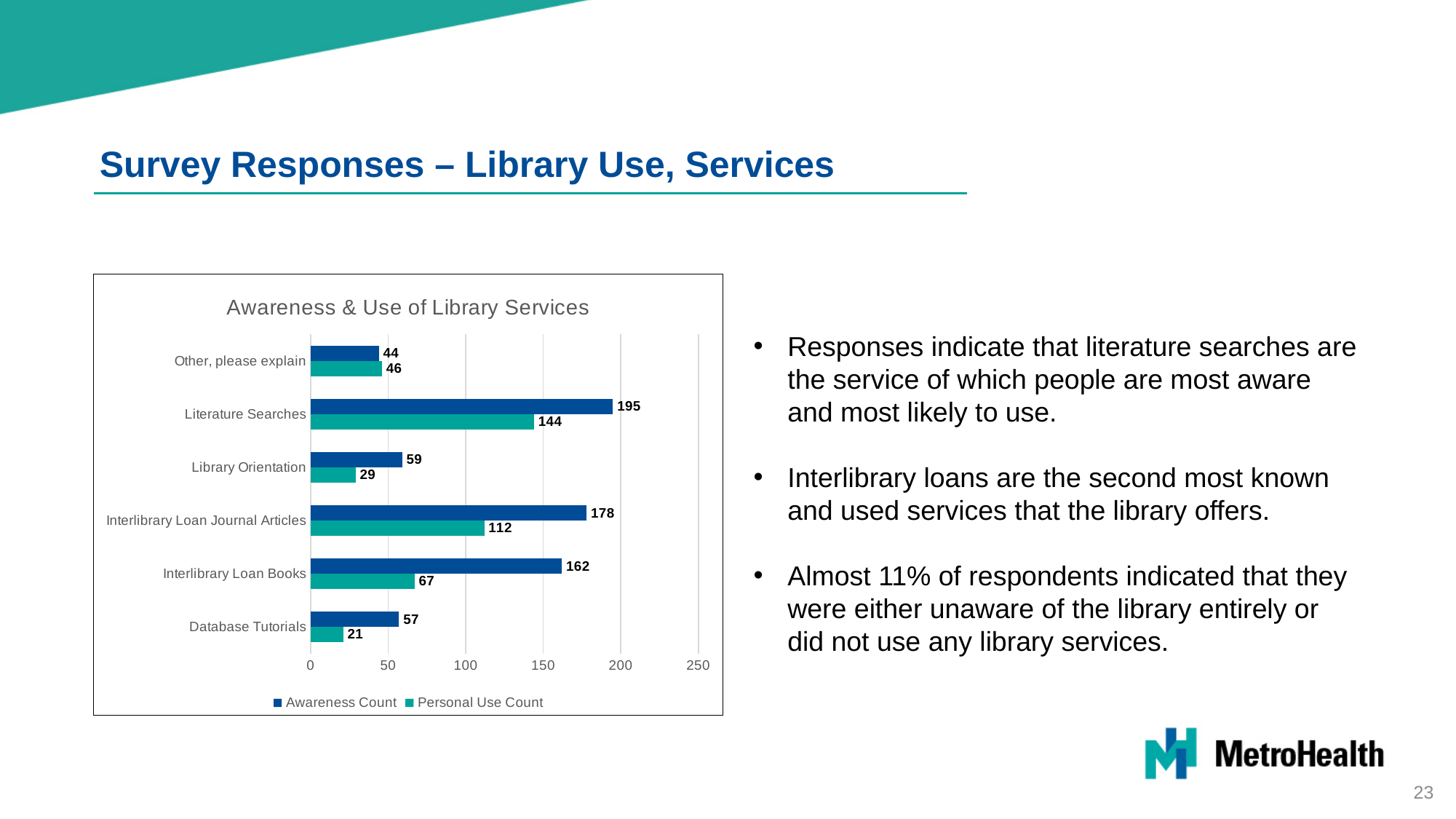
Which is larger for Other, please explain: the Awareness Count or the Personal Use Count? Personal Use Count What is the Personal Use Count for Interlibrary Loan Journal Articles? 112 Which category has the highest Awareness Count? Literature Searches What kind of chart is shown on the slide? Bar chart Which category has the lowest Personal Use Count? Database Tutorials How many series does the legend list? 2 What is the difference between the Awareness Count and the Personal Use Count for Interlibrary Loan Books? 95 What is the title of the chart? Awareness & Use of Library Services Is the Awareness Count for Interlibrary Loan Journal Articles greater or less than 150? greater What is the Awareness Count for Literature Searches? 195 How many categories are shown on the chart? 6 What is the Personal Use Count for Database Tutorials? 21